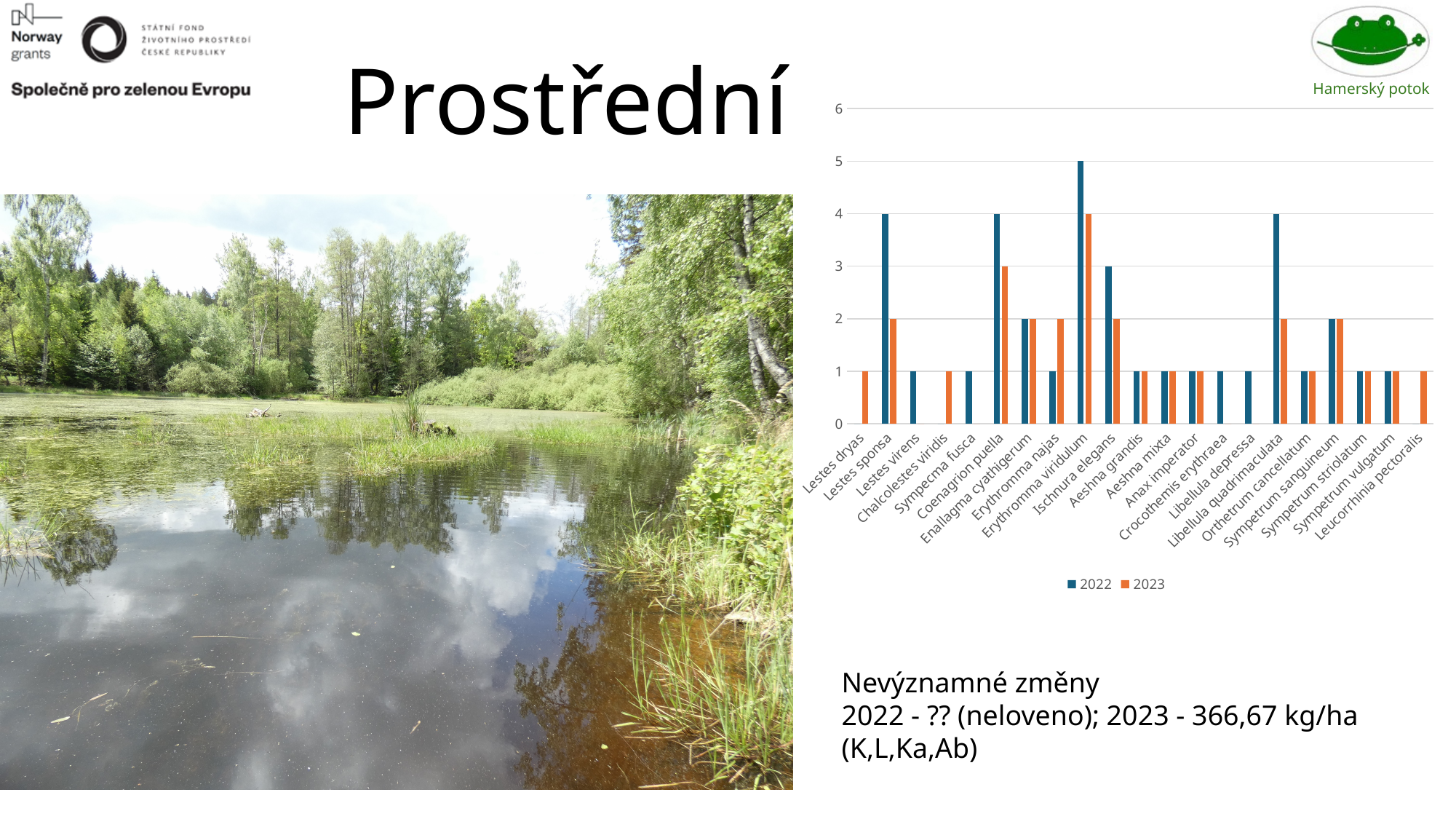
Is the 2022 value for Ischnura elegans greater or less than 2? greater Which species has the highest 2023 value? Erythromma viridulum What kind of chart is shown on the slide? bar chart What is the 2022 value for Erythromma viridulum? 5 What is the 2023 value for Coenagrion puella? 3 Which series are listed in the chart legend? 2022 and 2023 How many species categories are shown on the x axis of the chart? 21 What is the 2023 value for Lestes sponsa? 2 Which is larger for Erythromma najas, the 2022 value or the 2023 value? 2023 How many series does the chart legend list? 2 Which species has the highest 2022 value? Erythromma viridulum What is the difference between the 2022 and 2023 values for Libellula quadrimaculata? 2